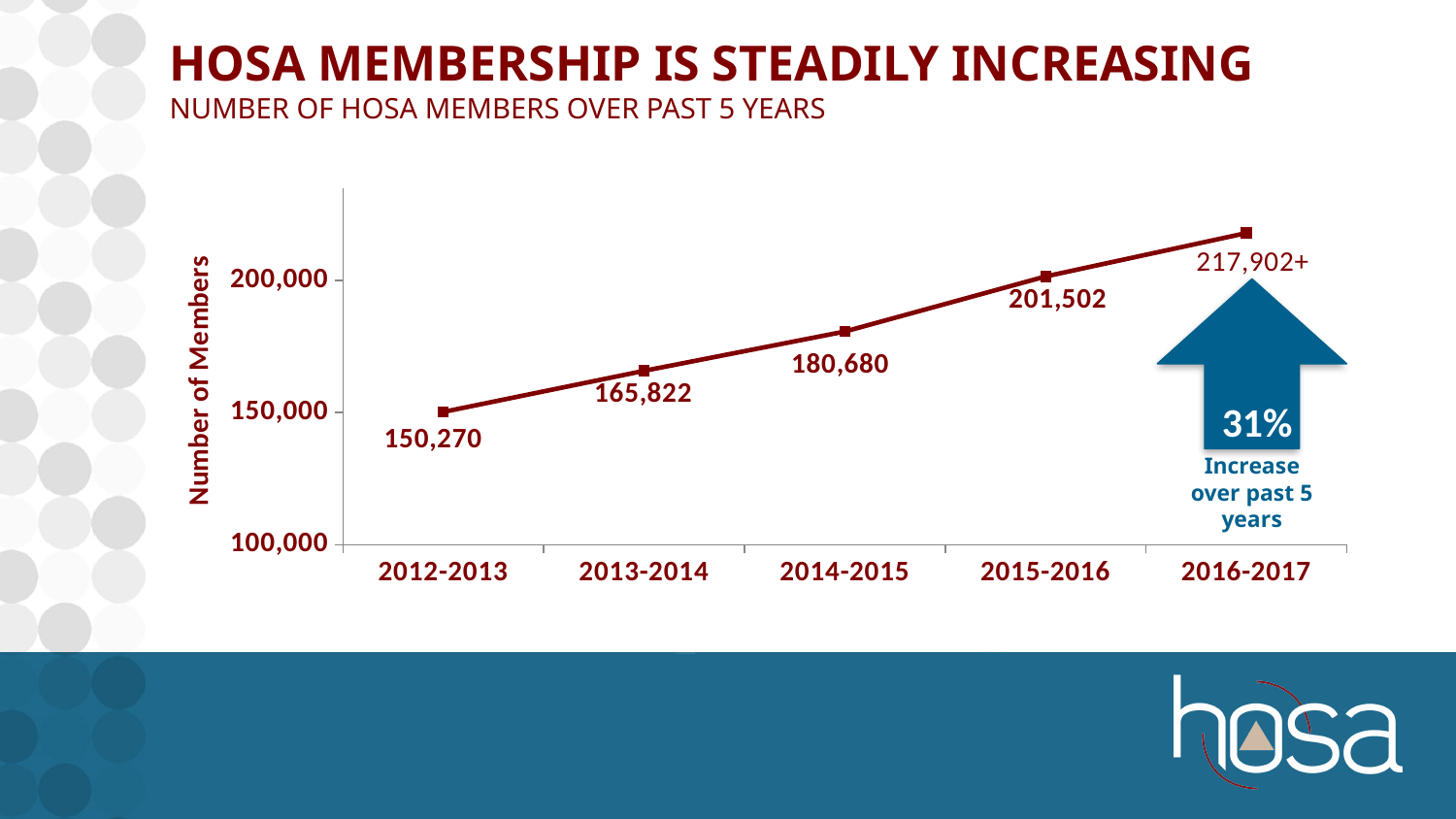
What value is labelled for 2016-2017? 217,902+ What is the number of HOSA members for 2015-2016? 201,502 What is the number of HOSA members for 2012-2013? 150,270 What is the difference in members between 2015-2016 and 2014-2015? 20,822 Which year has the highest number of members? 2016-2017 What kind of chart is shown on the slide? line chart What is the difference in members between 2013-2014 and 2012-2013? 15,552 Is the value for 2015-2016 greater or less than 200,000? greater How many years are plotted on the chart? 5 Which year has the lowest number of members? 2012-2013 What is the number of HOSA members for 2014-2015? 180,680 Which is larger, the number of members in 2013-2014 or in 2014-2015? 2014-2015